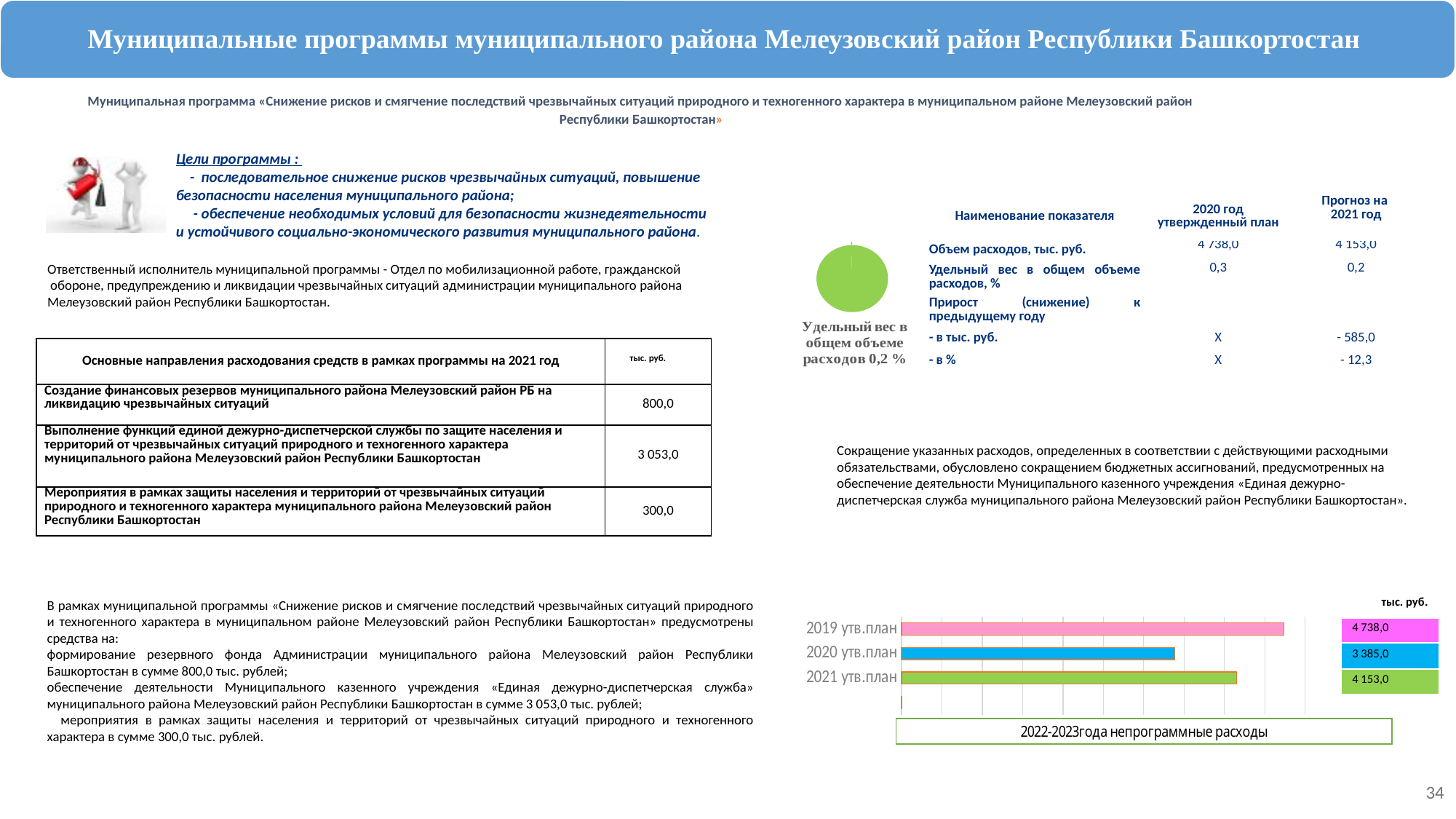
In the bar chart at the bottom right, what is the value for 2020 утв.план? 3 385,0 What kind of chart is shown at the bottom right of the slide? Bar chart In the bar chart at the bottom right, what unit is indicated above the data labels? тыс. руб. In the bar chart at the bottom right, what is the difference between the values for 2021 утв.план and 2020 утв.план? 768,0 What share of total expenditures does the small pie chart on the right side of the slide represent, according to its caption? 0,2 % In the bar chart at the bottom right, which is larger: the value for 2020 утв.план or 2021 утв.план? 2021 утв.план In the bar chart at the bottom right, what is the value for 2019 утв.план? 4 738,0 In the bar chart at the bottom right, what is the value for 2021 утв.план? 4 153,0 How many bars are shown in the bar chart at the bottom right? 3 In the bar chart at the bottom right, which category has the lowest value? 2020 утв.план In the bar chart at the bottom right, which category has the highest value? 2019 утв.план In the bar chart at the bottom right, what is the difference between the values for 2019 утв.план and 2021 утв.план? 585,0